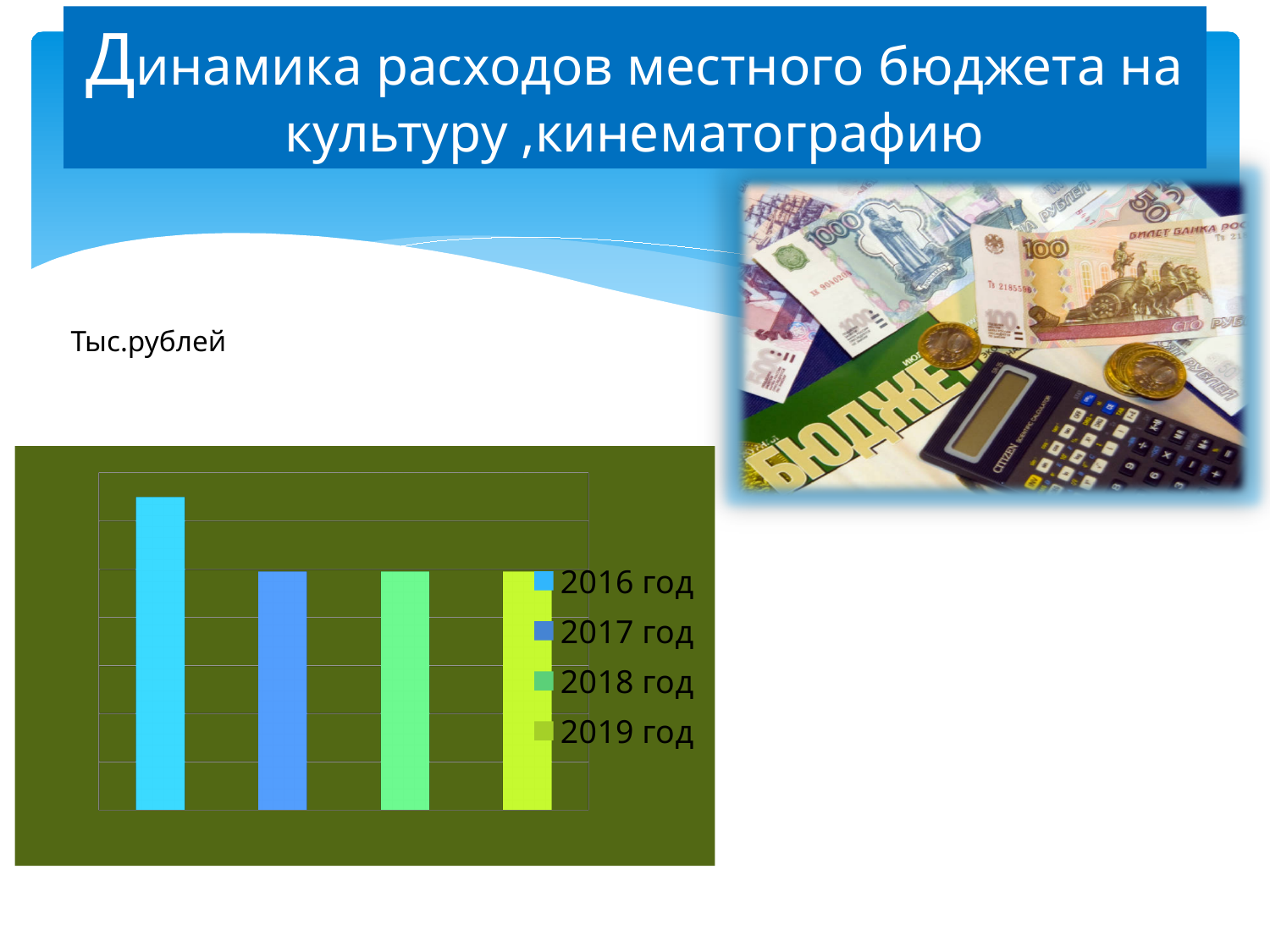
What kind of chart is shown on the slide? bar chart How many bars are plotted in the chart? 4 Which legend entry is shown in light blue (cyan)? 2016 год Which year has the highest bar in the chart? 2016 год Which is larger, the bar for 2016 год or the bar for 2019 год? 2016 год What unit is stated above the chart? Тыс.рублей How many entries does the chart legend list? 4 Which is larger, the bar for 2016 год or the bar for 2017 год? 2016 год Does the value fall or rise from 2016 год to 2017 год? fall